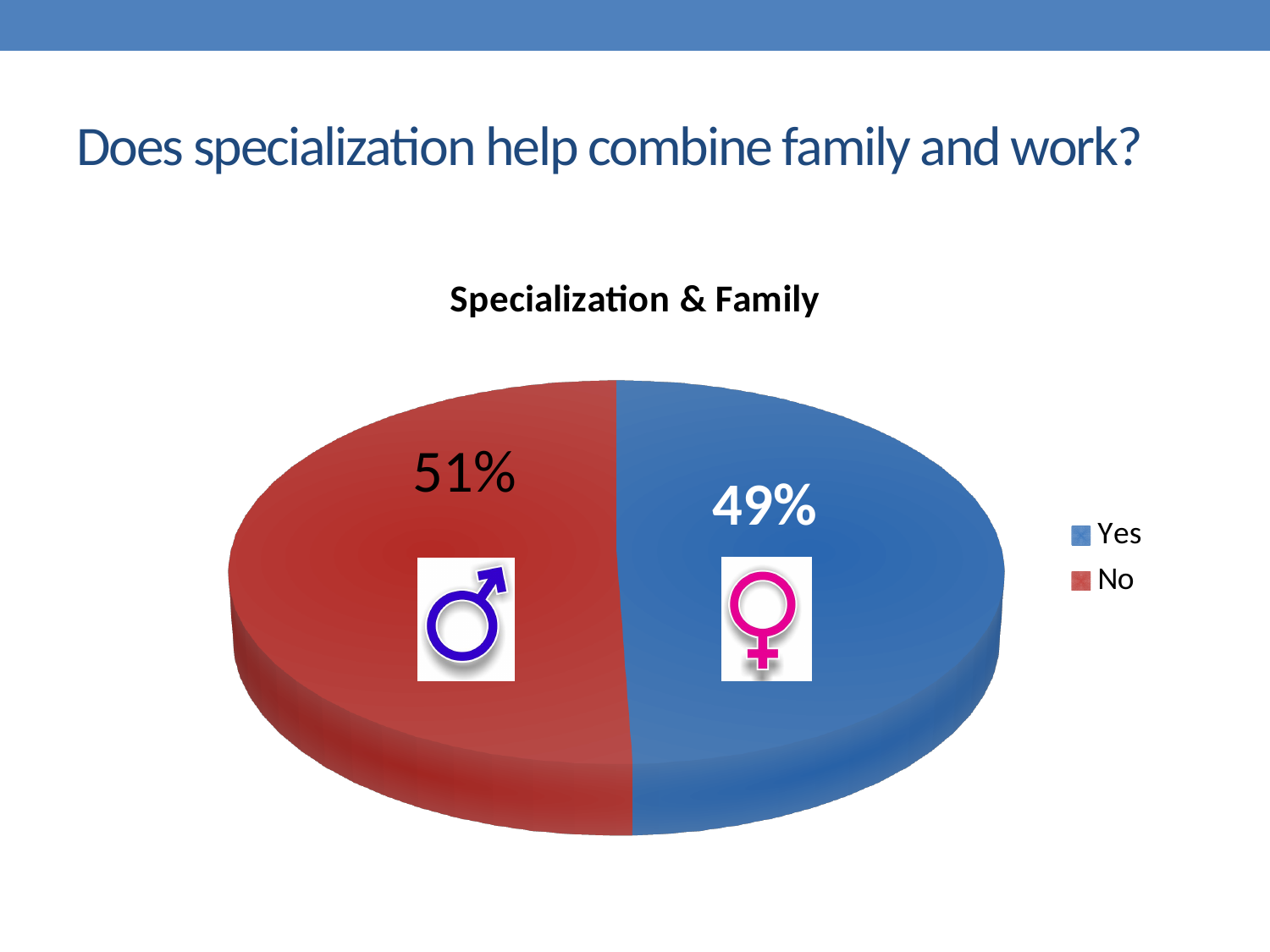
What colour is the "Yes" slice in the pie chart? blue What type of chart is shown on the slide? pie chart How many slices does the pie chart have? 2 How many entries does the legend list? 2 What is the title of the chart? Specialization & Family Which is larger, the "Yes" slice or the "No" slice? No What percentage of the pie is labelled for the "Yes" slice? 49% Which slice of the pie is the smallest? Yes What share of the pie does the "Yes" slice represent? 49% What percentage of the pie is labelled for the "No" slice? 51% Which slice of the pie is the largest? No What is the difference in percentage points between the "No" slice and the "Yes" slice? 2